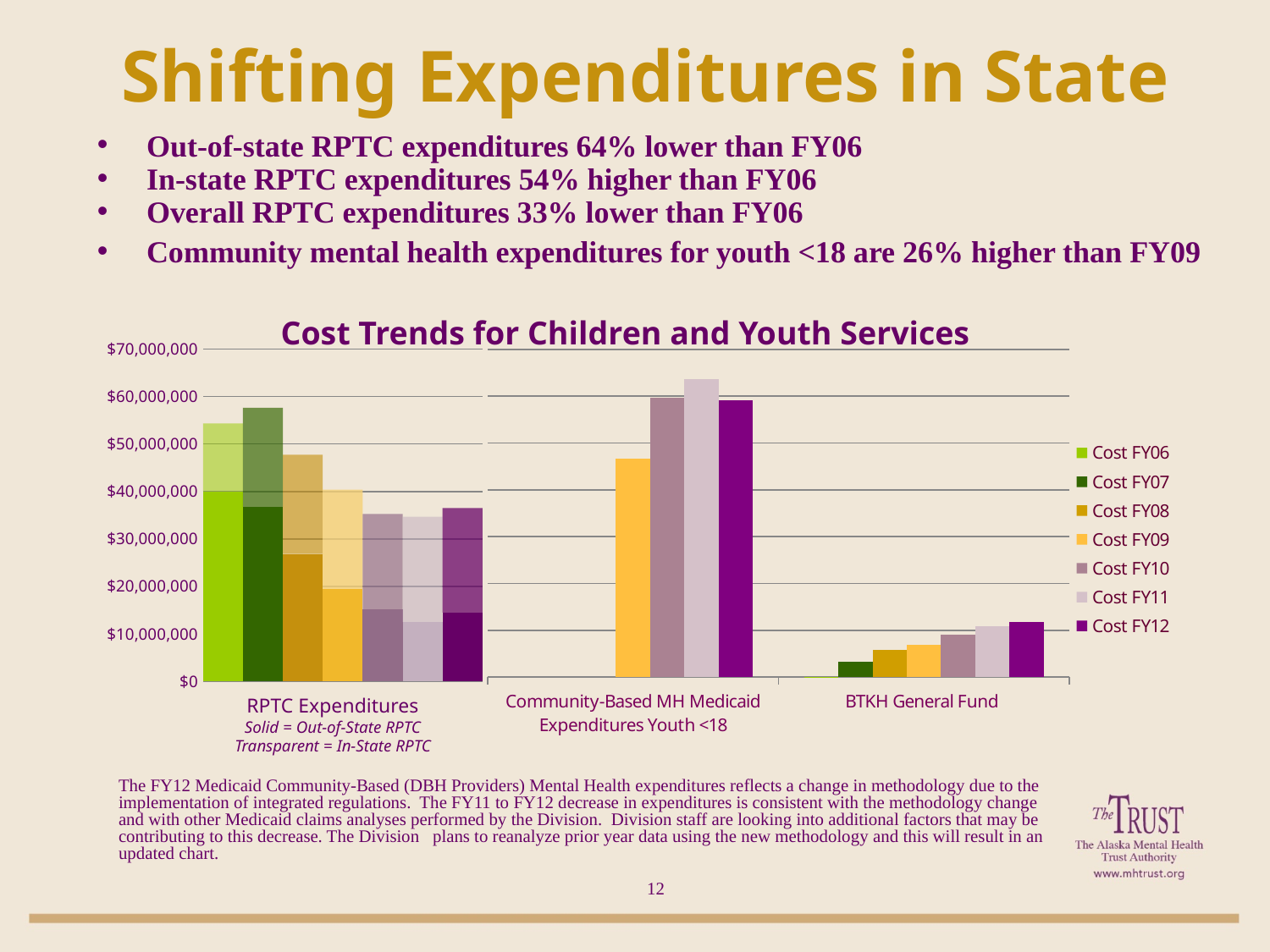
How many categories are shown along the x axis of the chart? 3 How many series does the chart legend list? 7 Which fiscal year has the highest bar in the Community-Based MH Medicaid Expenditures Youth <18 category? Cost FY11 Do the BTKH General Fund values rise or fall from Cost FY06 to Cost FY12? Rise What kind of chart is shown on the slide? Bar chart What is the title of the chart? Cost Trends for Children and Youth Services Is the Cost FY07 value for BTKH General Fund greater or less than $10,000,000? less In the Community-Based MH Medicaid Expenditures Youth <18 category, which is larger, the Cost FY09 bar or the Cost FY10 bar? Cost FY10 Which fiscal year has the lowest bar in the BTKH General Fund category? Cost FY06 Is the Cost FY09 value for Community-Based MH Medicaid Expenditures Youth <18 greater or less than $40,000,000? greater Is the Cost FY12 value for BTKH General Fund greater or less than $10,000,000? greater